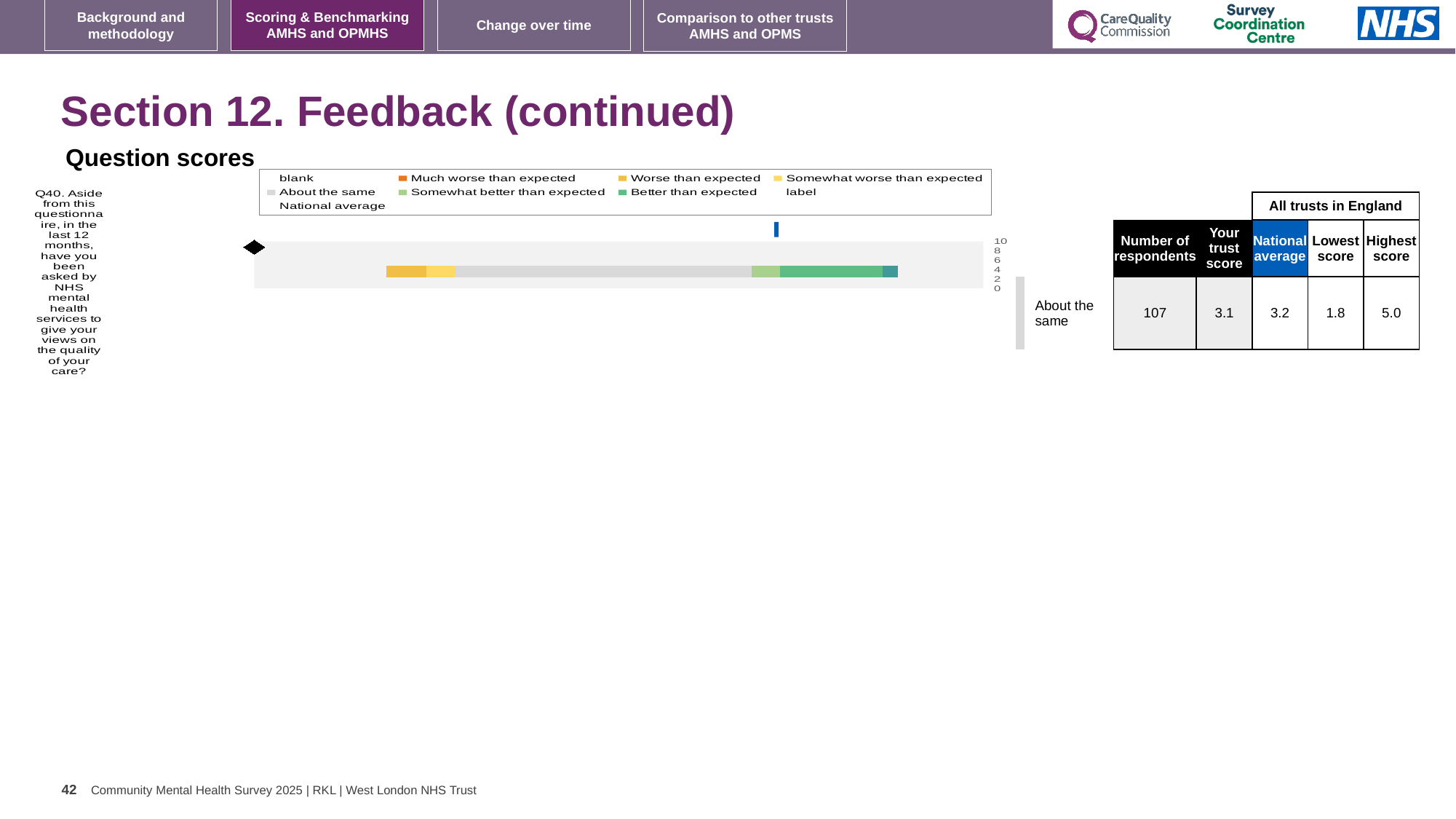
What kind of chart is shown under 'Question scores'? bar chart For Q40, which is larger: the trust score or the national average? national average In the table beside the 'Question scores' chart, what is the national average for Q40? 3.2 How many entries does the legend of the 'Question scores' chart list? 9 For Q40, what is the difference between the highest score and the lowest score among all trusts in England? 3.2 Which legend entry in the 'Question scores' chart is shown in orange? Much worse than expected What is the title shown above the chart? Question scores In the table beside the 'Question scores' chart, what is the number of respondents for Q40? 107 In the table beside the 'Question scores' chart, what is the 'Your trust score' for Q40? 3.1 What rating category is shown to the right of the bar for Q40 in the 'Question scores' chart? About the same How many questions are plotted in the 'Question scores' chart? 1 In the table beside the 'Question scores' chart, what is the highest score among all trusts in England for Q40? 5.0